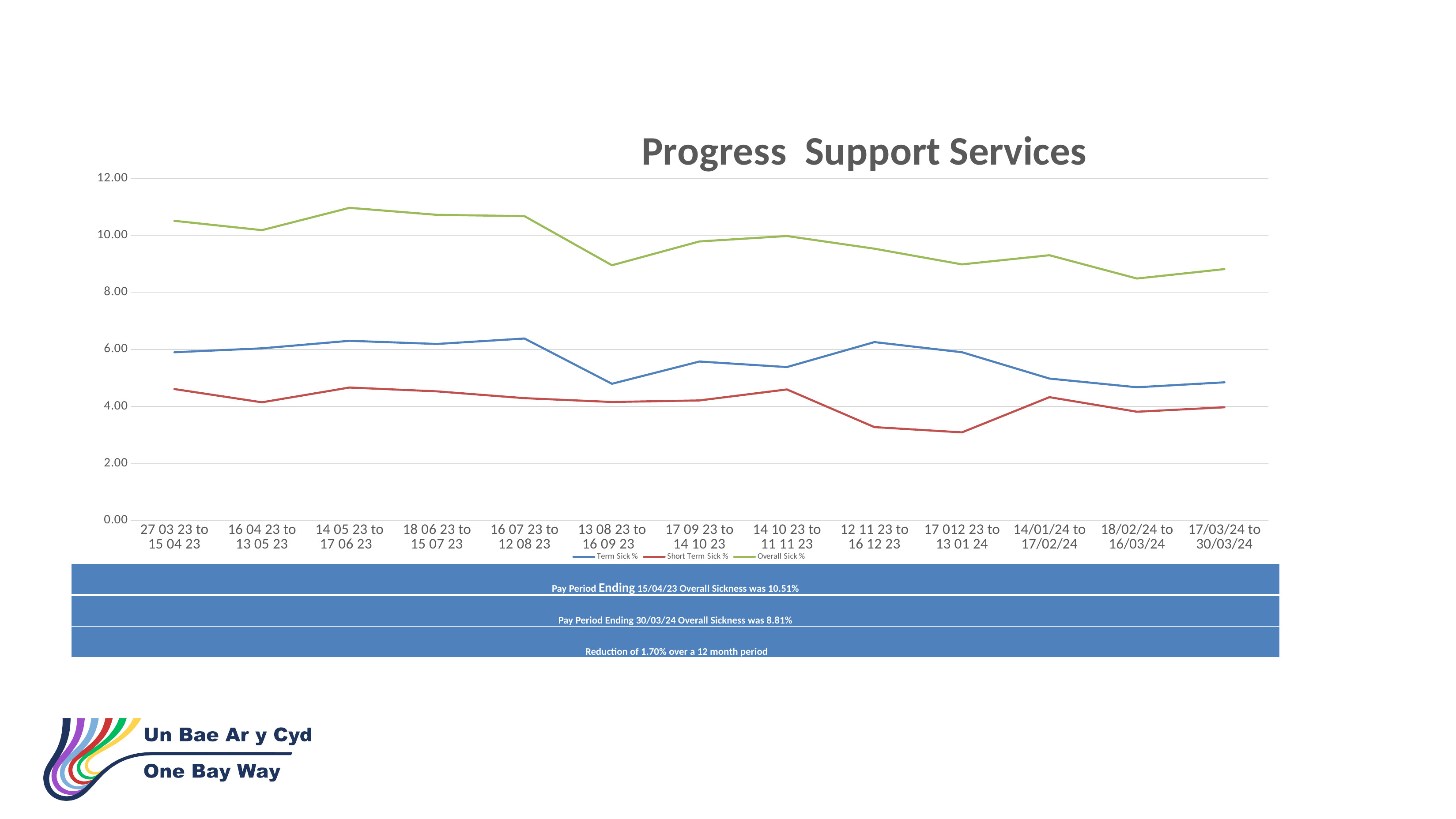
In which pay period is Overall Sick % highest? 14 05 23 to 17 06 23 What is the title of the chart? Progress Support Services In which pay period is Overall Sick % lowest? 18/02/24 to 16/03/24 Is the Short Term Sick % value for 17 012 23 to 13 01 24 greater or less than 4.00? less How many pay periods are plotted along the x axis? 13 Which series is drawn in green? Overall Sick % How many series does the legend list? 3 By how much did Overall Sickness reduce between the pay period ending 15/04/23 and the pay period ending 30/03/24? 1.70% Is the Overall Sick % value for 13 08 23 to 16 09 23 greater or less than 10.00? less What kind of chart is shown on the slide? line chart According to the slide, what was Overall Sickness for the pay period ending 30/03/24? 8.81% According to the slide, what was Overall Sickness for the pay period ending 15/04/23? 10.51%